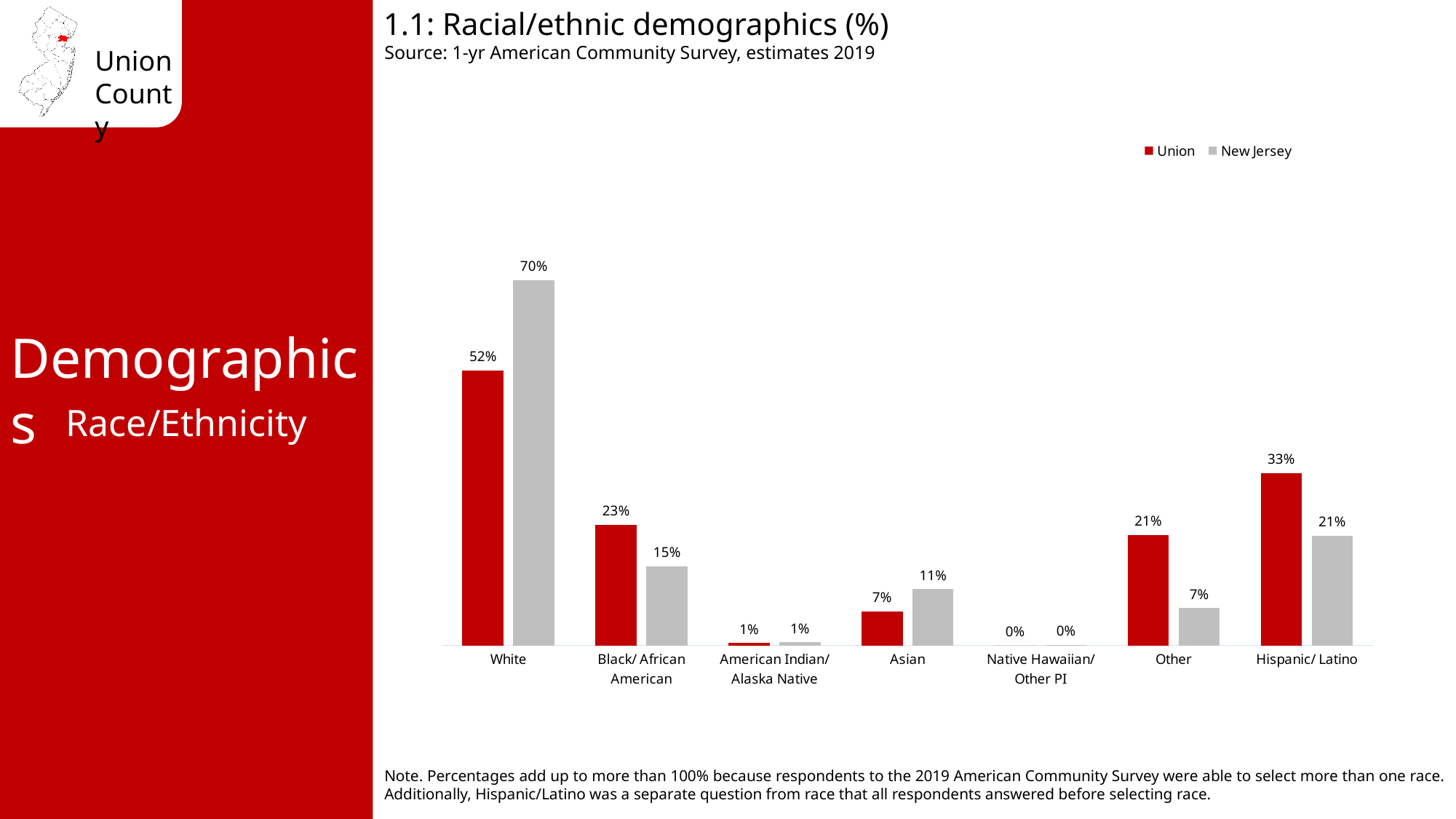
Which category has the lowest Union value? Native Hawaiian/ Other PI Which is larger for Other: the Union value or the New Jersey value? Union What kind of chart is shown? Bar chart What is the New Jersey value for Black/ African American? 15% What is the Union value for Hispanic/ Latino? 33% What is the Union value for White? 52% How many series does the legend list? 2 What is the difference between the New Jersey and Union values for White? 18% What is the New Jersey value for Asian? 11% How many categories are shown on the x axis? 7 What colour are the Union bars? Red Which category has the highest New Jersey value? White